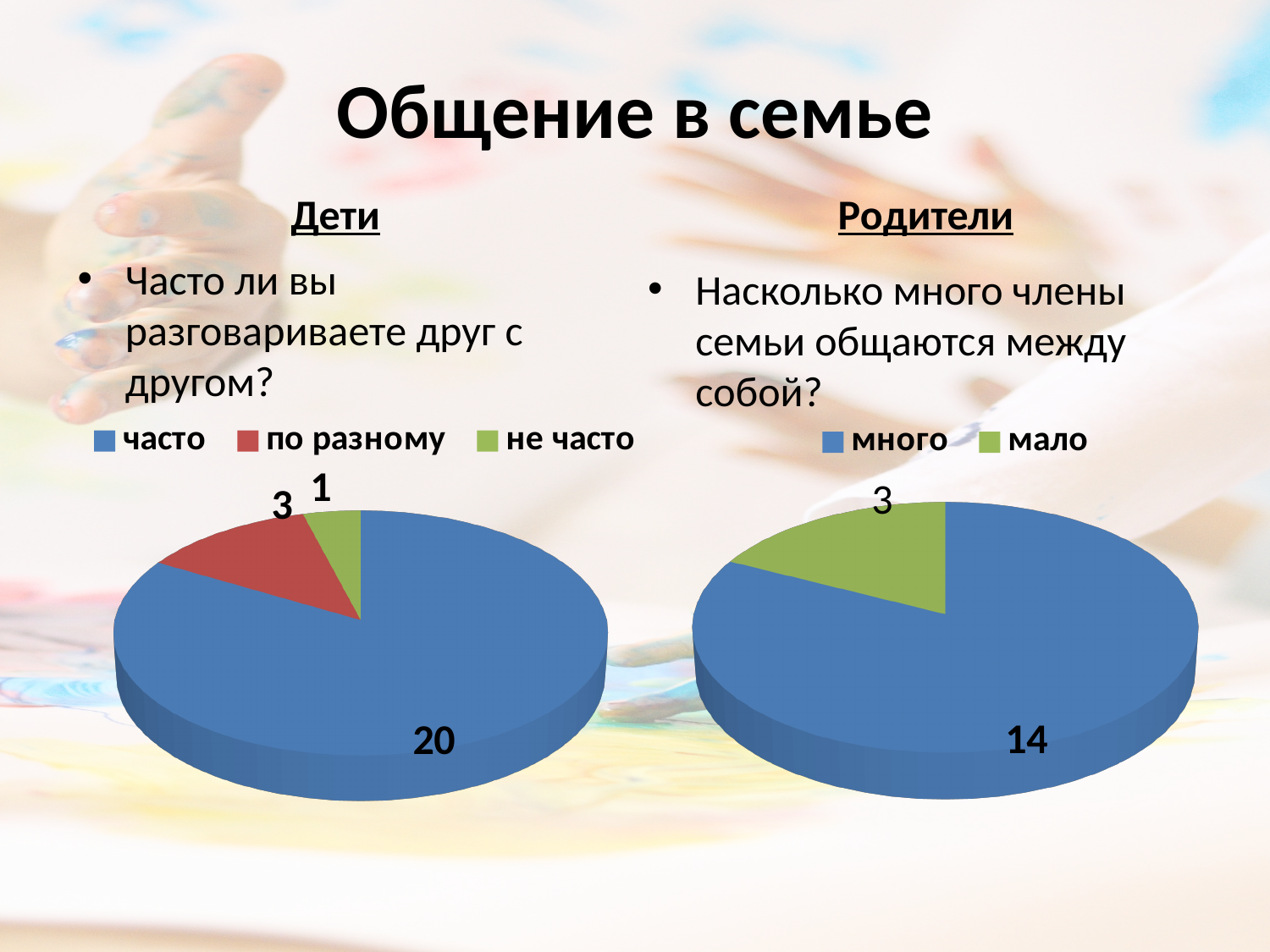
In the left pie chart (Дети), which category has the smallest slice? не часто In the left pie chart (Дети), how many categories does the legend list? 3 In the right pie chart (Родители), what is the difference between "много" and "мало"? 11 What type of chart is used on the right side of the slide (Родители)? pie chart In the left pie chart (Дети), what is the value for "часто"? 20 In the left pie chart (Дети), what share of the total does "по разному" represent? 12.5% In the right pie chart (Родители), what is the value for "много"? 14 In the left pie chart (Дети), which category has the largest slice? часто In the left pie chart (Дети), what is the difference between "часто" and "по разному"? 17 In the right pie chart (Родители), what is the value for "мало"? 3 In the left pie chart (Дети), what is the value for "не часто"? 1 In the left pie chart (Дети), what is the value for "по разному"? 3